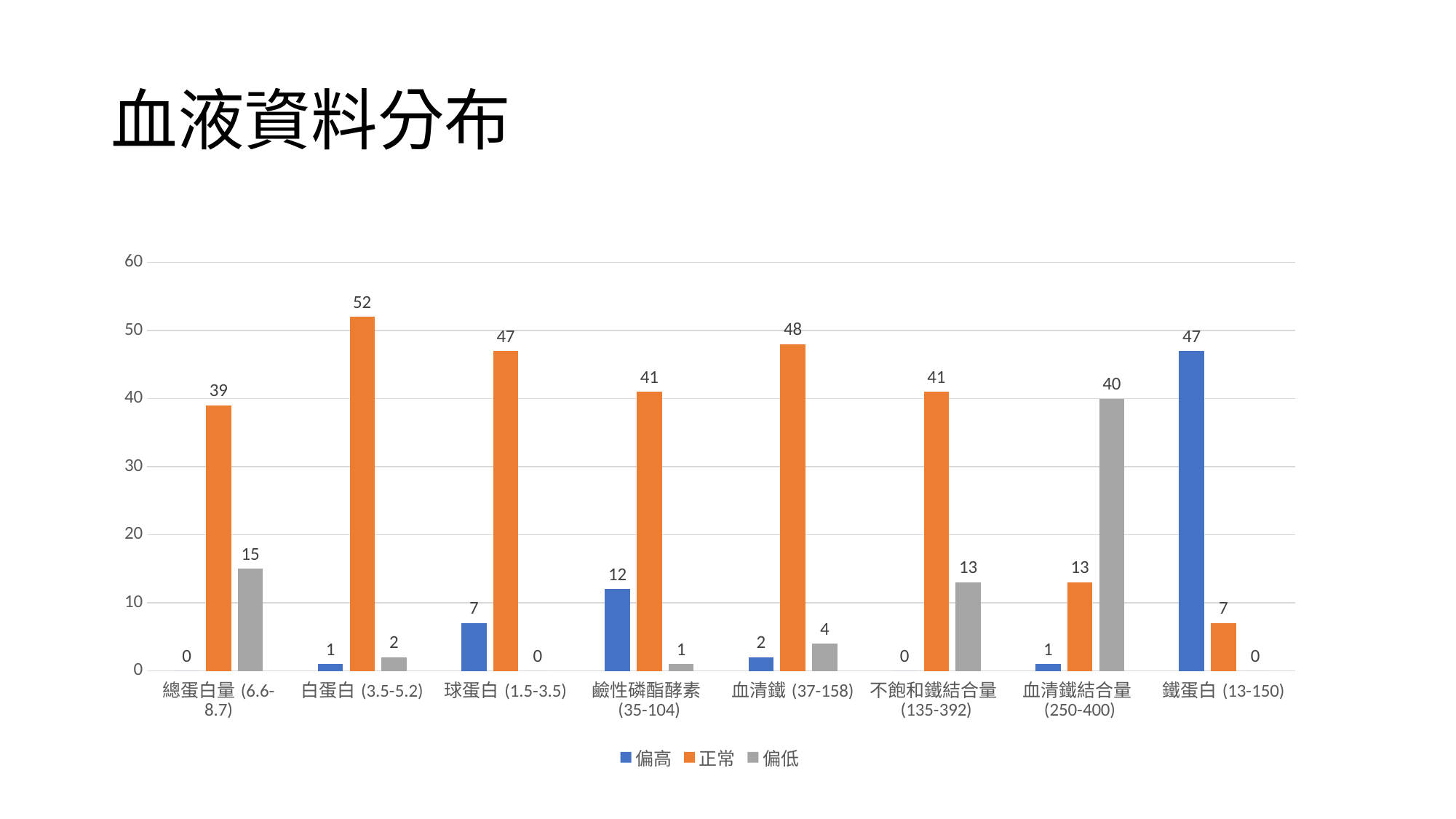
What is the title of the slide? 血液資料分布 What is the total of the three values for 鹼性磷酯酵素 (35-104)? 54 Which category has the highest 正常 value? 白蛋白 (3.5-5.2) Which is larger: the 偏低 value for 總蛋白量 (6.6-8.7) or the 偏低 value for 不飽和鐵結合量 (135-392)? 總蛋白量 (6.6-8.7) How many series does the legend list? 3 What is the 正常 value for 白蛋白 (3.5-5.2)? 52 What is the 偏高 value for 鐵蛋白 (13-150)? 47 What kind of chart is shown on the slide? bar chart How many categories are shown on the x axis? 8 What is the difference between the 正常 value for 血清鐵 (37-158) and the 正常 value for 總蛋白量 (6.6-8.7)? 9 Which category has the highest 偏高 value? 鐵蛋白 (13-150) What is the 偏低 value for 血清鐵結合量 (250-400)? 40